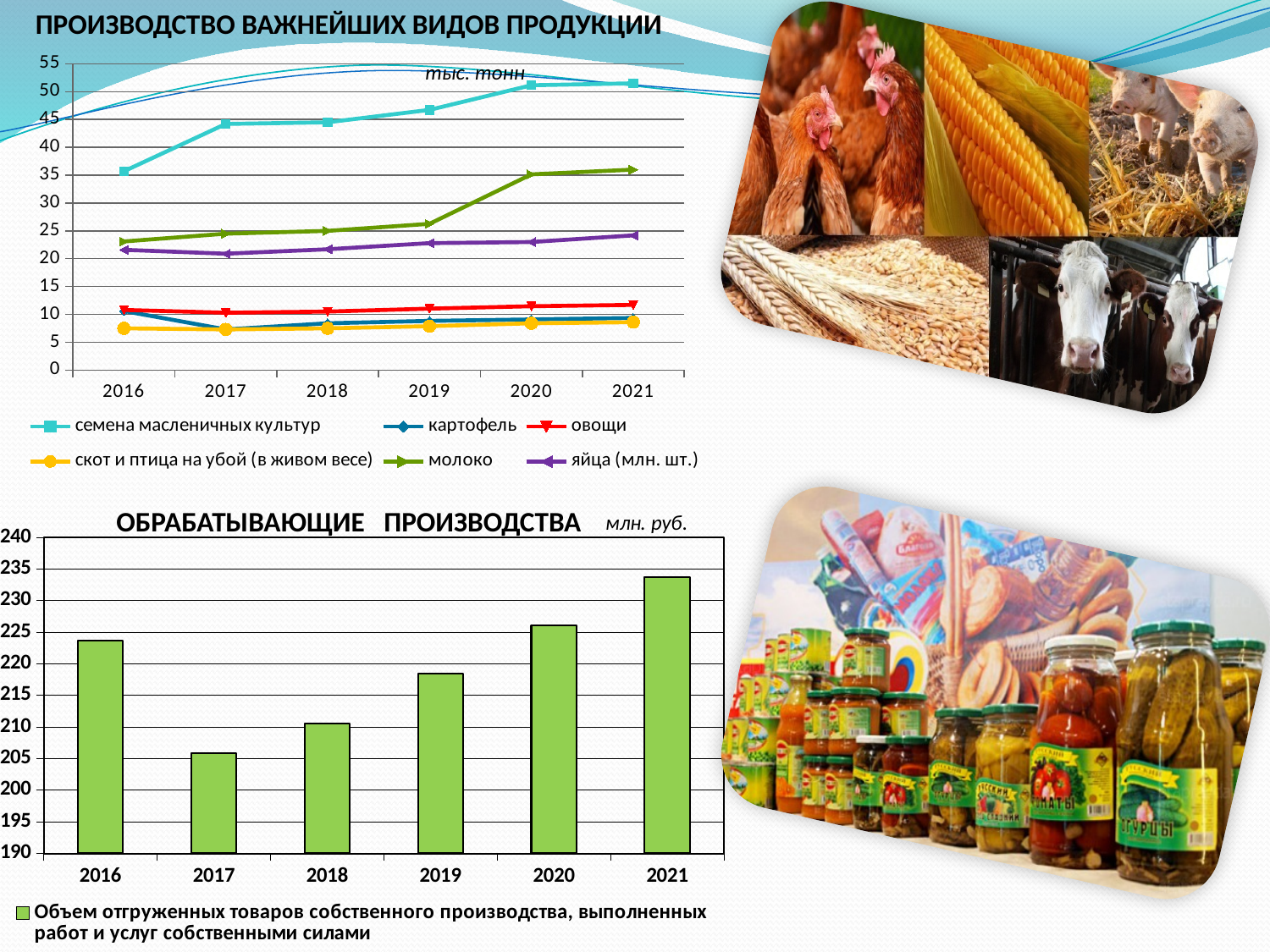
In the top chart 'ПРОИЗВОДСТВО ВАЖНЕЙШИХ ВИДОВ ПРОДУКЦИИ', which series has the highest value in 2021? семена масленичных культур How many years are shown on the x axis of the bottom chart 'ОБРАБАТЫВАЮЩИЕ ПРОИЗВОДСТВА'? 6 How many series does the legend of the top chart 'ПРОИЗВОДСТВО ВАЖНЕЙШИХ ВИДОВ ПРОДУКЦИИ' list? 6 In the top chart 'ПРОИЗВОДСТВО ВАЖНЕЙШИХ ВИДОВ ПРОДУКЦИИ', is the value for молоко in 2021 greater or less than 30? greater What kind of chart is the bottom chart titled 'ОБРАБАТЫВАЮЩИЕ ПРОИЗВОДСТВА'? bar chart In the bottom chart 'ОБРАБАТЫВАЮЩИЕ ПРОИЗВОДСТВА', which year has the lowest value? 2017 In the top chart 'ПРОИЗВОДСТВО ВАЖНЕЙШИХ ВИДОВ ПРОДУКЦИИ', does the series семена масленичных культур rise or fall from 2016 to 2021? rise In the top chart 'ПРОИЗВОДСТВО ВАЖНЕЙШИХ ВИДОВ ПРОДУКЦИИ', which series has the lowest value in 2016? скот и птица на убой (в живом весе) What kind of chart is the top chart titled 'ПРОИЗВОДСТВО ВАЖНЕЙШИХ ВИДОВ ПРОДУКЦИИ'? line chart In the bottom chart 'ОБРАБАТЫВАЮЩИЕ ПРОИЗВОДСТВА', is the value for 2019 greater or less than 215? greater In the bottom chart 'ОБРАБАТЫВАЮЩИЕ ПРОИЗВОДСТВА', which year has the highest value? 2021 What unit is shown on the top chart 'ПРОИЗВОДСТВО ВАЖНЕЙШИХ ВИДОВ ПРОДУКЦИИ'? тыс. тонн